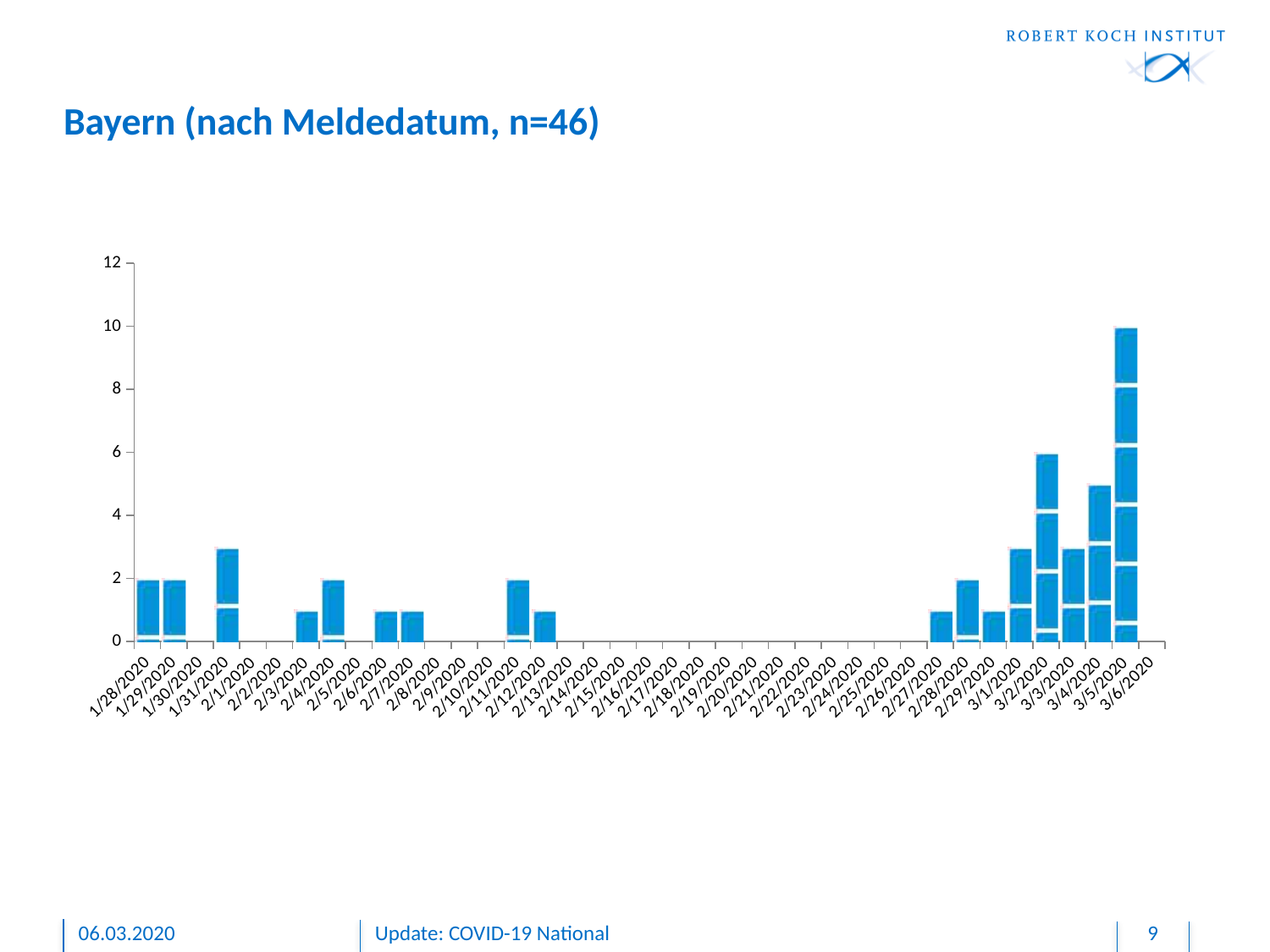
Which date has the highest value in the chart? 3/5/2020 How many dates are shown on the x axis? 39 Which is larger, the value for 3/5/2020 or the value for 3/2/2020? 3/5/2020 Do the values generally rise or fall from 2/27/2020 to 3/5/2020? rise What type of chart is shown on the slide? bar chart Is the value for 3/4/2020 greater or less than 4? greater Is the value for 1/31/2020 greater or less than 2? greater What is the title of the chart? Bayern (nach Meldedatum, n=46) Is the value for 2/3/2020 greater or less than 2? less What is the value for 1/28/2020? 2 What is the value for 3/5/2020? 10 What is the value for 3/2/2020? 6